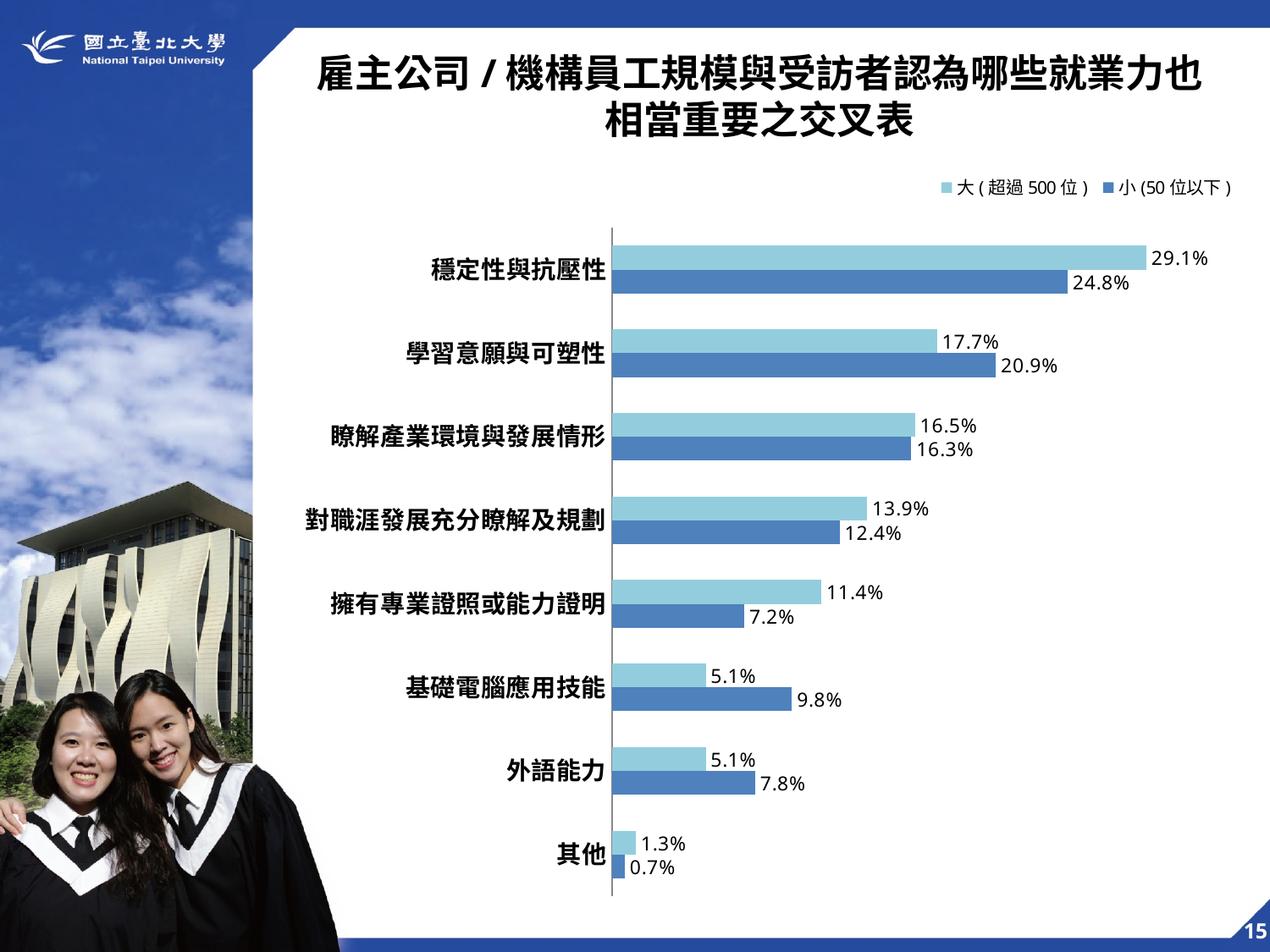
For 對職涯發展充分瞭解及規劃, which series has the larger value, 大 ( 超過 500 位 ) or 小 (50 位以下 )? 大 ( 超過 500 位 ) What is the difference between the 大 ( 超過 500 位 ) and 小 (50 位以下 ) values for 穩定性與抗壓性? 4.3% What is the value for 擁有專業證照或能力證明 in the 小 (50 位以下 ) series? 7.2% Which category has the lowest value in the 小 (50 位以下 ) series? 其他 For 外語能力, which series has the larger value, 大 ( 超過 500 位 ) or 小 (50 位以下 )? 小 (50 位以下 ) Which category has the highest value in the 大 ( 超過 500 位 ) series? 穩定性與抗壓性 What is the difference between the 小 (50 位以下 ) and 大 ( 超過 500 位 ) values for 學習意願與可塑性? 3.2% How many categories are shown on the chart? 8 What is the value for 穩定性與抗壓性 in the 大 ( 超過 500 位 ) series? 29.1% How many series does the legend list? 2 What kind of chart is shown on the slide? Bar chart What is the value for 基礎電腦應用技能 in the 小 (50 位以下 ) series? 9.8%